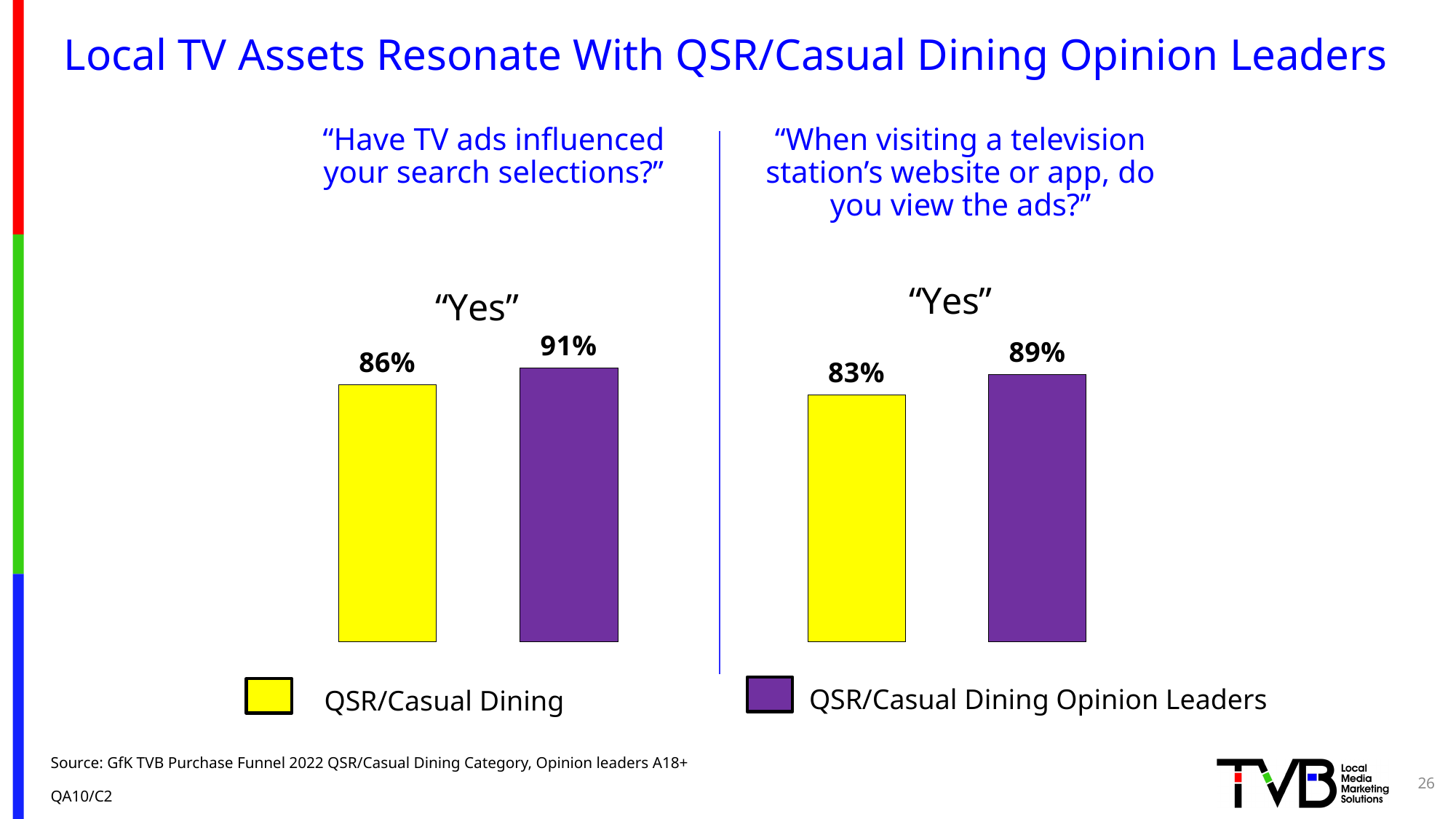
In the left chart ("Have TV ads influenced your search selections?"), what percentage of QSR/Casual Dining respondents said "Yes"? 86% In the right chart ("When visiting a television station's website or app, do you view the ads?"), what is the value for QSR/Casual Dining? 83% In the right chart ("When visiting a television station's website or app, do you view the ads?"), what is the difference in percentage points between QSR/Casual Dining Opinion Leaders and QSR/Casual Dining? 6 percentage points In the right chart ("When visiting a television station's website or app, do you view the ads?"), which group has the lower value? QSR/Casual Dining In the left chart ("Have TV ads influenced your search selections?"), which group has the higher "Yes" percentage? QSR/Casual Dining Opinion Leaders Which colour represents QSR/Casual Dining Opinion Leaders in the legend? Purple Is the QSR/Casual Dining value in the left chart (86%) larger or smaller than the QSR/Casual Dining value in the right chart (83%)? larger In the left chart ("Have TV ads influenced your search selections?"), what is the difference in percentage points between QSR/Casual Dining Opinion Leaders and QSR/Casual Dining? 5 percentage points In the right chart ("When visiting a television station's website or app, do you view the ads?"), what is the value for QSR/Casual Dining Opinion Leaders? 89% What type of chart is used on this slide? Bar chart How many bars are shown in the right chart ("When visiting a television station's website or app, do you view the ads?")? 2 In the left chart ("Have TV ads influenced your search selections?"), what percentage of QSR/Casual Dining Opinion Leaders said "Yes"? 91%